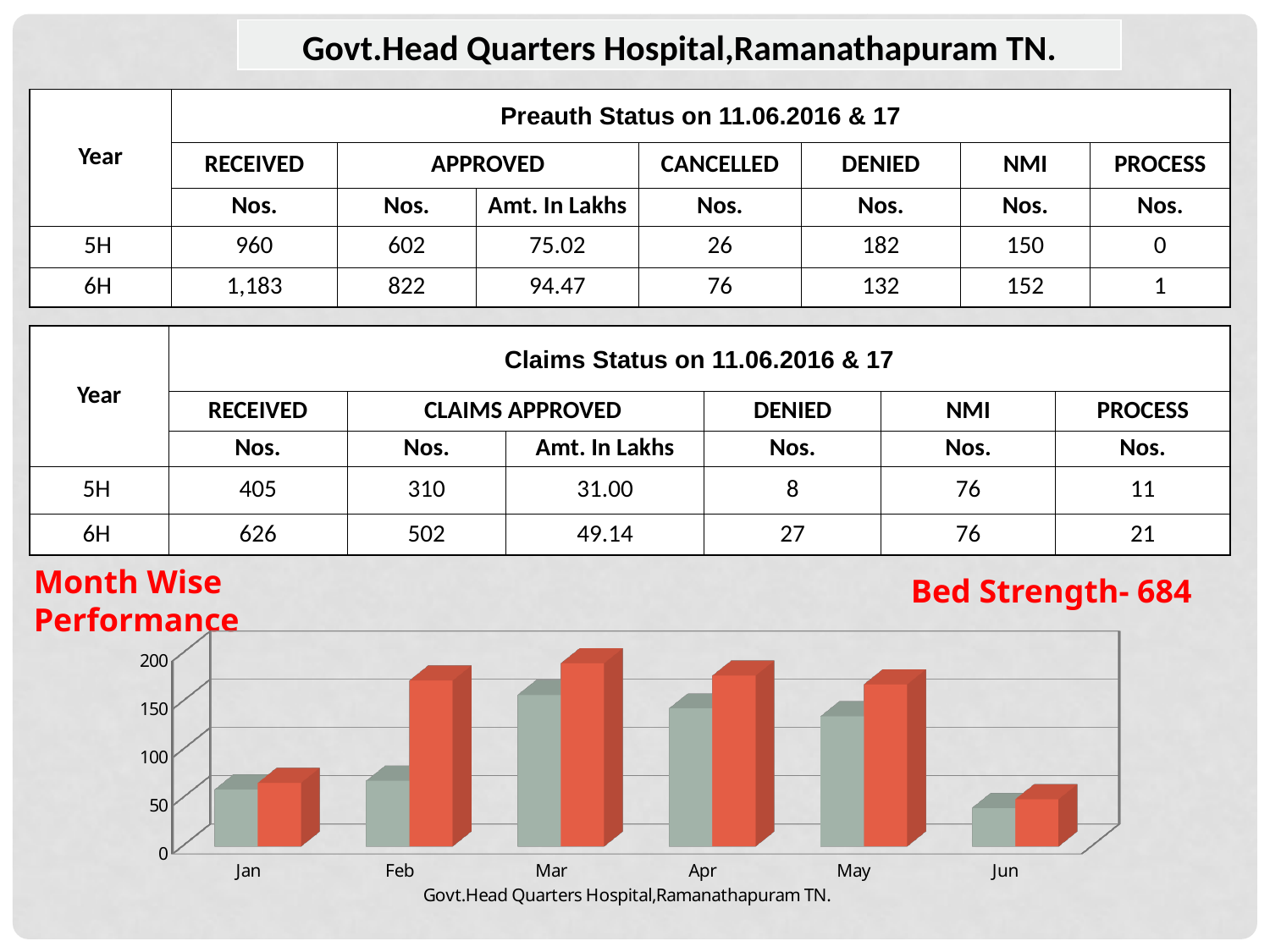
In which month is the red bar the tallest? Mar Do the red bars rise or fall from Mar to Jun? fall Is the red bar for Feb greater or less than 150? greater What text appears below the x axis of the chart? Govt.Head Quarters Hospital,Ramanathapuram TN. In which month is the grey bar the tallest? Mar For Feb, which bar is taller, the grey bar or the red bar? the red bar How many data series (bar colours) are plotted in the chart? 2 In which month is the red bar the shortest? Jun How many months are shown on the x axis of the chart? 6 Is the red bar for Jun greater or less than 100? less Is the grey bar for Jan greater or less than 100? less What kind of chart is shown on the slide? bar chart